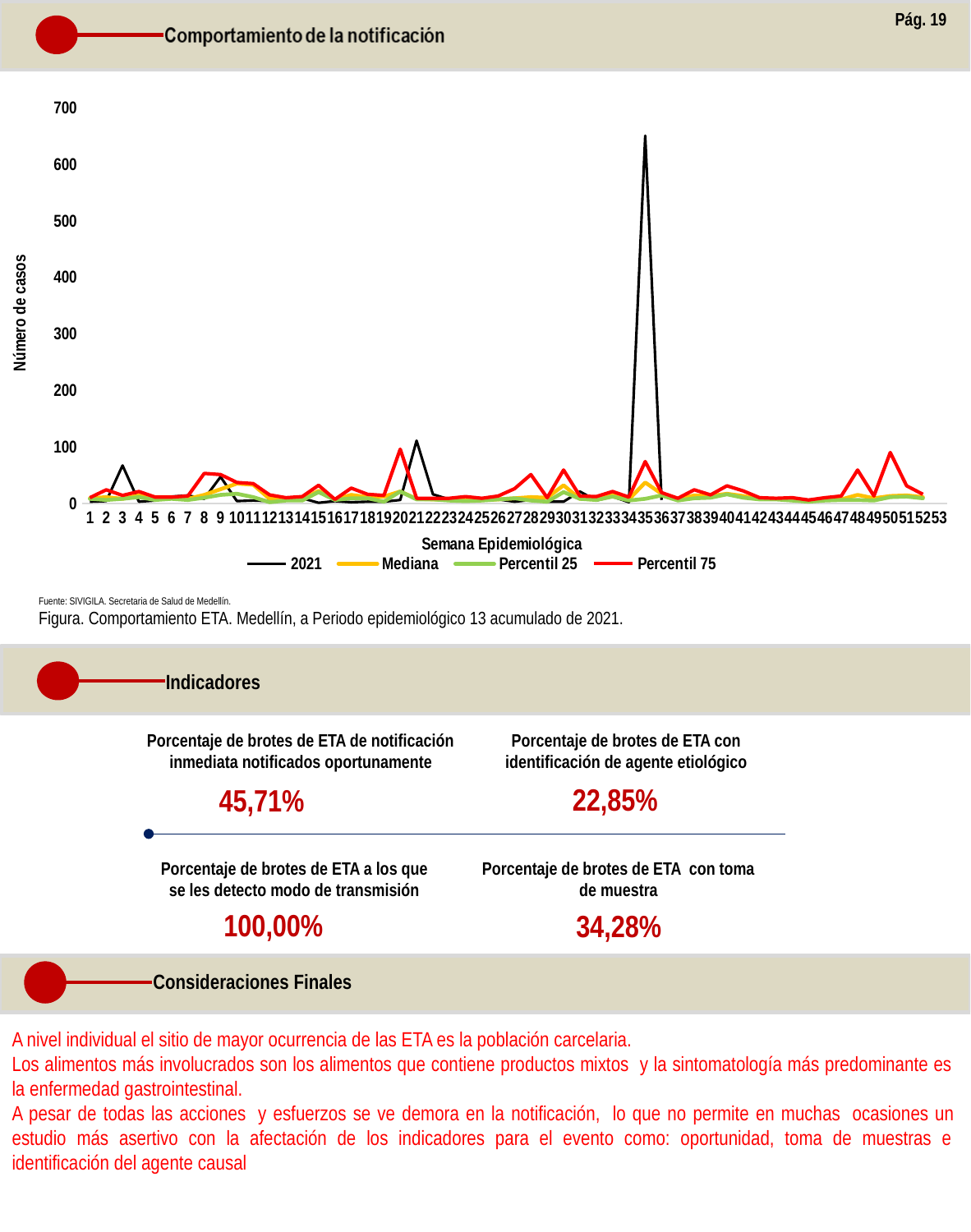
Is the value of the 2021 series in week 35 greater or less than 600? greater In week 35, which series has the larger value, 2021 or Percentil 75? 2021 What is the title of the vertical axis of the chart? Número de casos Is the value of the Percentil 75 series in week 35 greater or less than 100? less Is the value of the 2021 series in week 3 greater or less than 100? less How many series does the chart legend list? 4 What are the series names listed in the chart legend? 2021, Mediana, Percentil 25, Percentil 75 How many epidemiological weeks are shown on the x axis of the chart? 53 In which epidemiological week does the 2021 series reach its highest value? 35 What kind of chart is shown on the slide? line chart